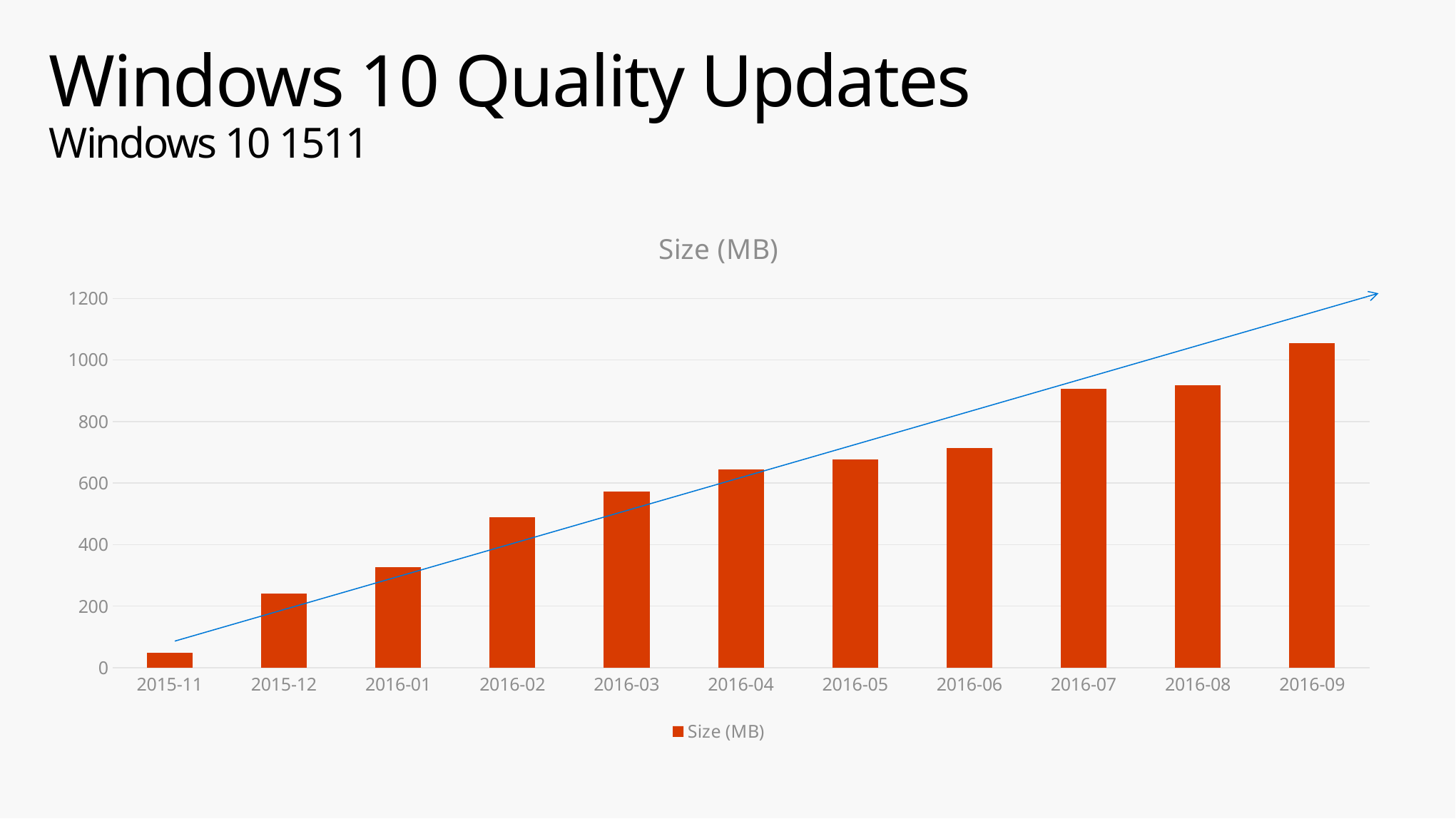
Is the value for 2016-09 greater or less than 1000? greater Is the value for 2016-02 greater or less than 400? greater Is the value for 2015-11 greater or less than 200? less Which month has the highest Size (MB)? 2016-09 How many bars (months) are plotted in the chart? 11 How many series does the legend list? 1 Do the values generally rise or fall from 2015-11 to 2016-09? rise What is the title of the chart? Size (MB) Which is larger, the value for 2016-01 or the value for 2016-09? 2016-09 What kind of chart is shown on the slide? bar chart Which month has the lowest Size (MB)? 2015-11